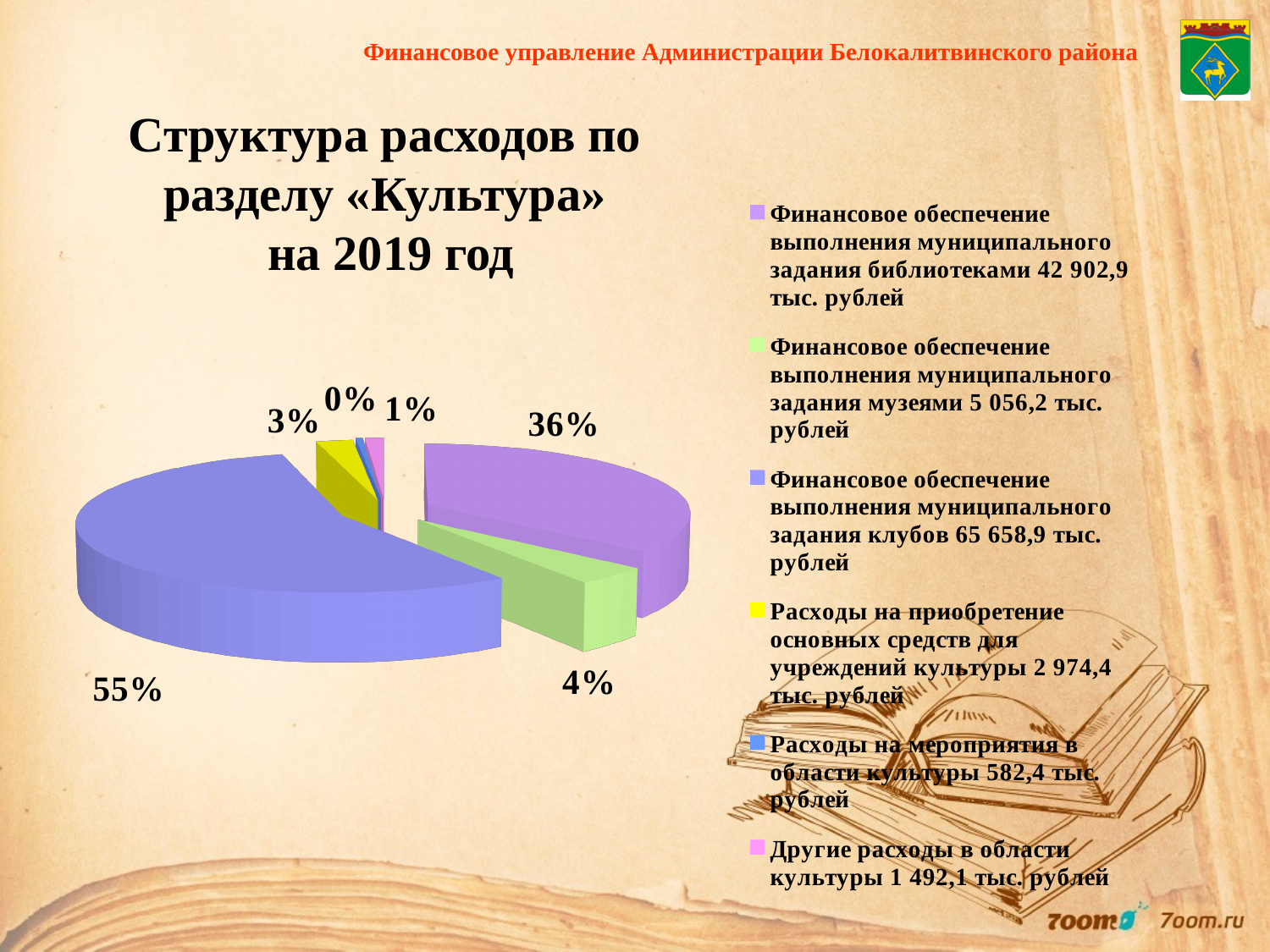
What is the difference in percentage points between the clubs slice and the libraries slice? 19 What share of the pie is labelled for the museums (музеями) slice? 4% Which category has the largest share of the pie? Финансовое обеспечение выполнения муниципального задания клубов What share of the pie is labelled for the purchase of fixed assets (приобретение основных средств) slice? 3% What kind of chart is shown on the slide? pie chart Which is larger: the share for museums or the share for purchase of fixed assets? museums What share of the pie is labelled for the libraries (библиотеками) slice? 36% How many entries does the legend list? 6 According to the legend, what amount is given for financial support of the municipal task of clubs? 65 658,9 тыс. рублей Which category has the smallest share of the pie? Расходы на мероприятия в области культуры How many slices does the pie chart have? 6